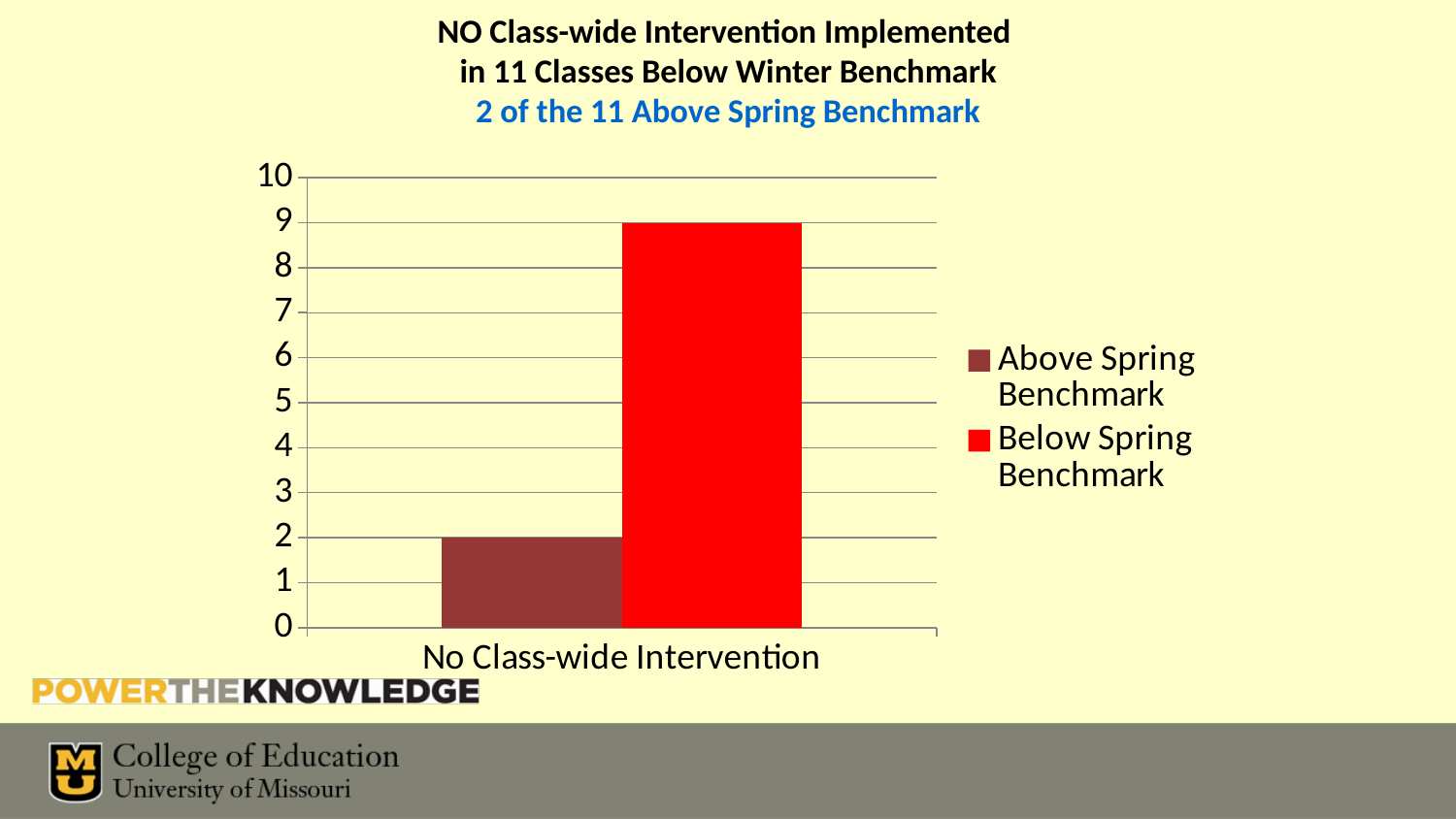
How many categories are shown on the x axis? 1 What is the label of the single category on the x axis? No Class-wide Intervention Which series has the highest value in the chart? Below Spring Benchmark How many series does the legend list? 2 Which series has the higher value: Above Spring Benchmark or Below Spring Benchmark? Below Spring Benchmark What is the difference between the Below Spring Benchmark value and the Above Spring Benchmark value? 7 What is the value for Below Spring Benchmark in the No Class-wide Intervention category? 9 What colour is the bar for Below Spring Benchmark? red Which series has the lowest value in the chart? Above Spring Benchmark What is the value for Above Spring Benchmark in the No Class-wide Intervention category? 2 What kind of chart is shown on the slide? bar chart Is the value for Below Spring Benchmark greater or less than 5? greater